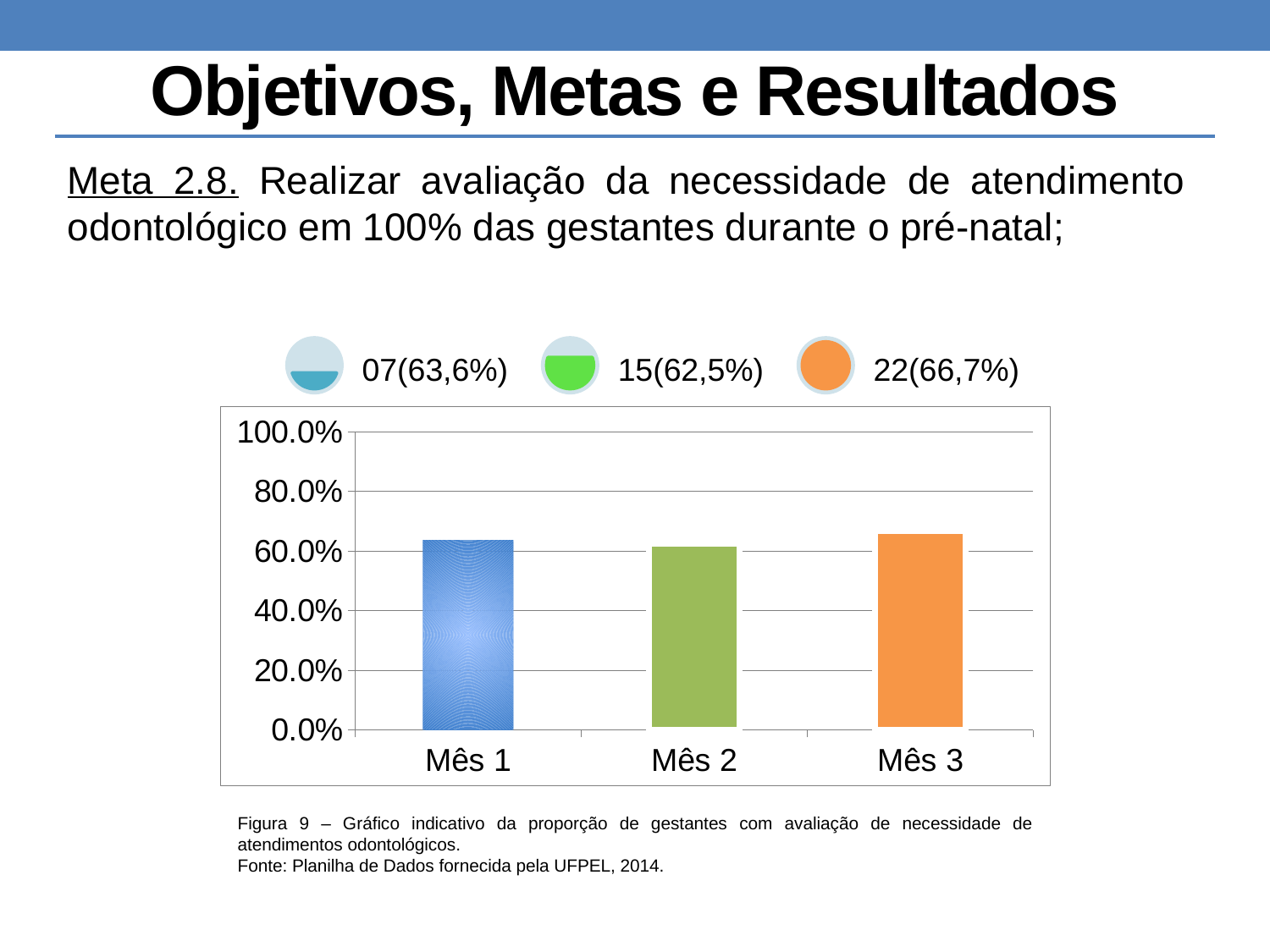
According to the legend, what is the value for Mês 2 (the green bar)? 15(62,5%) How many entries does the chart's legend list? 3 Which is larger, the value for Mês 3 or the value for Mês 2? Mês 3 How many categories (months) are shown on the x axis of the chart? 3 Is the value for Mês 3 greater or less than 80.0%? less What kind of chart is shown on the slide? bar chart Which month has the lowest proportion in the chart? Mês 2 Is the value for Mês 1 greater or less than 60.0%? greater According to the legend, what is the value for Mês 1 (the blue bar)? 07(63,6%) According to the legend, what is the value for Mês 3 (the orange bar)? 22(66,7%) What is the figure number given in the caption below the chart? Figura 9 Which month has the highest proportion in the chart? Mês 3